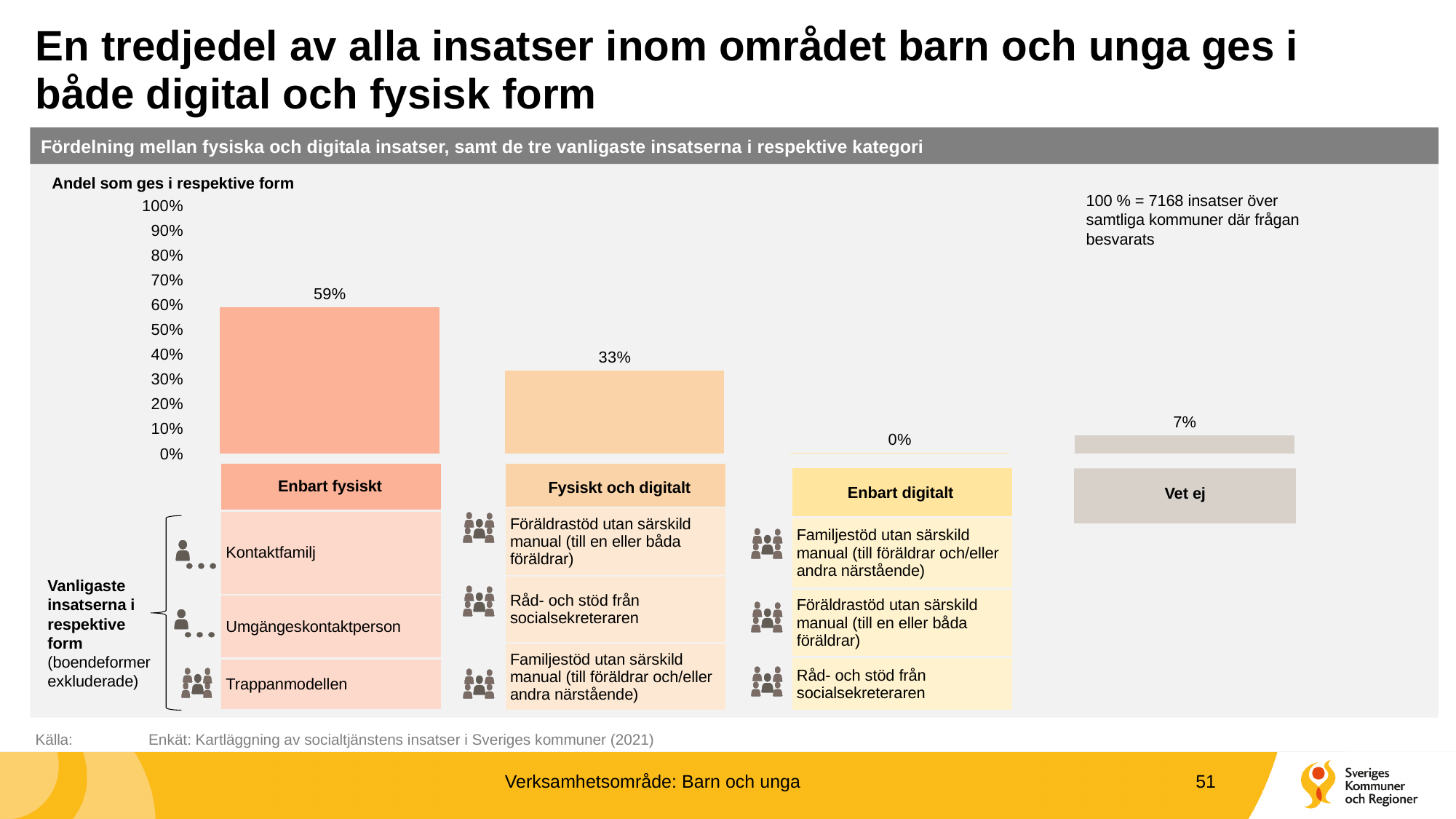
According to the note on the slide, how many insatser does 100% correspond to? 7168 Which category has the lowest value? Enbart digitalt What is the value for Vet ej? 7% Which category has the highest value? Enbart fysiskt What is the difference between Enbart fysiskt and Fysiskt och digitalt? 26% Which is larger, Vet ej or Fysiskt och digitalt? Fysiskt och digitalt What is the value for Enbart fysiskt? 59% What is the title of the chart's axis label above the y axis? Andel som ges i respektive form What kind of chart is shown on the slide? Bar chart How many categories are shown in the chart? 4 What is the value for Enbart digitalt? 0% What is the value for Fysiskt och digitalt? 33%